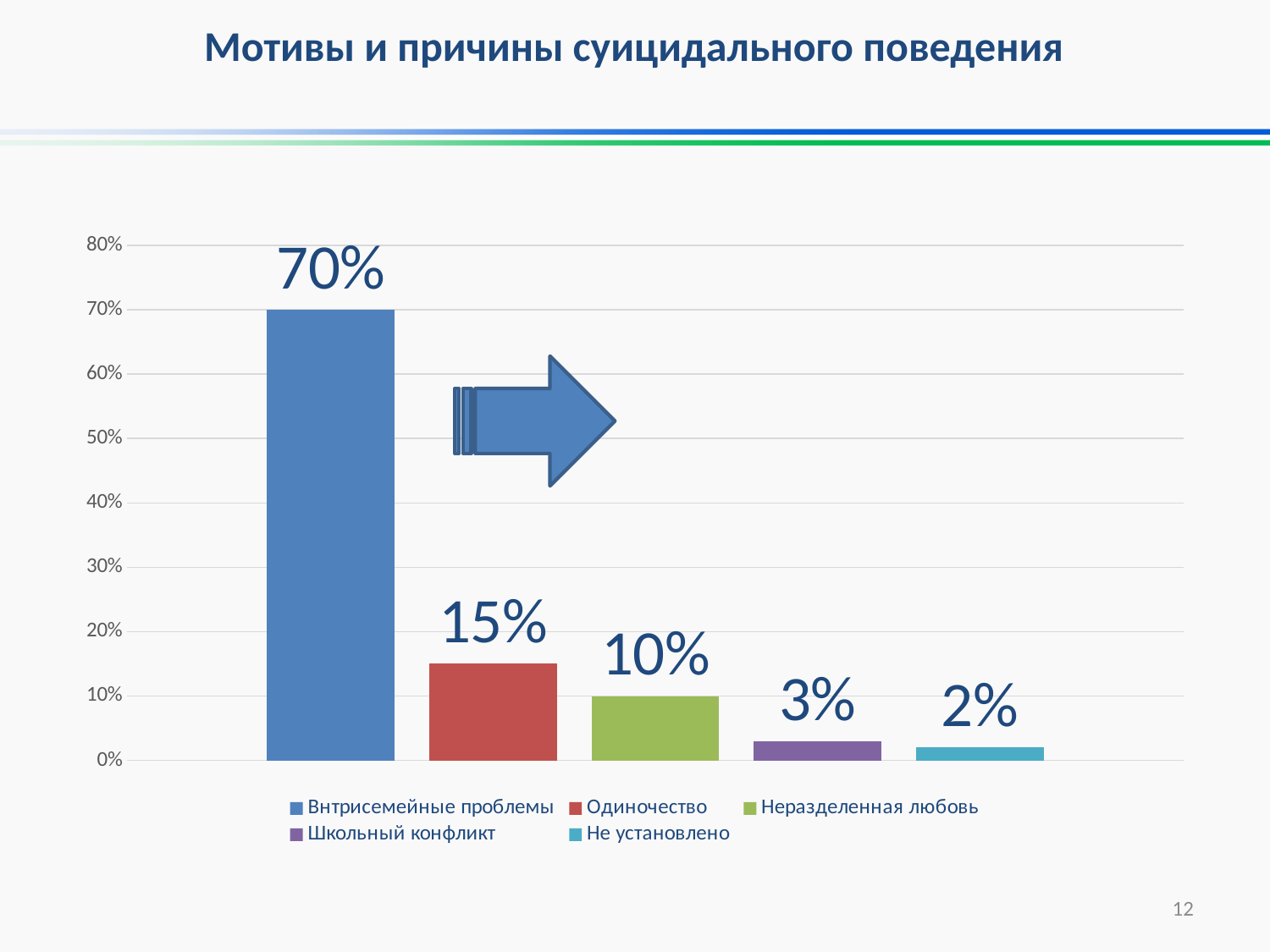
Which is larger, the value for Одиночество or the value for Неразделенная любовь? Одиночество What is the value for Не установлено? 2% What is the value for Неразделенная любовь? 10% What is the value for Школьный конфликт? 3% What kind of chart is shown on the slide? Bar chart What is the difference between the values for Внтрисемейные проблемы and Одиночество? 55% Which category has the lowest value? Не установлено How many categories does the legend list? 5 Which category has the highest value? Внтрисемейные проблемы What is the title of the slide? Мотивы и причины суицидального поведения What is the value for Внтрисемейные проблемы? 70% What is the value for Одиночество? 15%